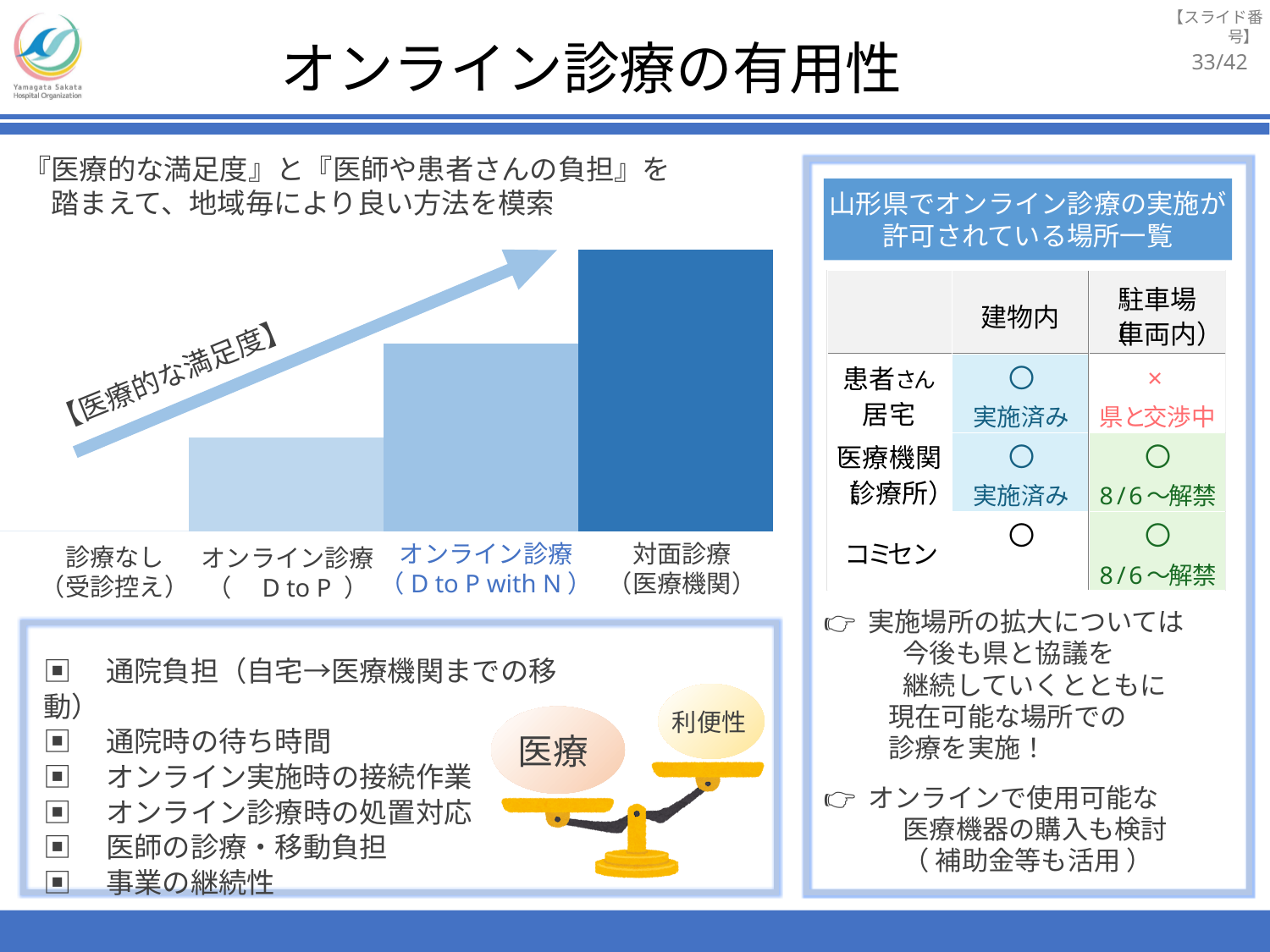
In the bar chart on the left, which category has the shortest bar? 診療なし（受診控え） What kind of chart is shown on the left side of the slide under the heading about 医療的な満足度? bar chart In the bar chart on the left, which bar is taller: オンライン診療（D to P）or オンライン診療（D to P with N）? オンライン診療（D to P with N） In the bar chart on the left, do the bars rise or fall from left to right? rise In the bar chart on the left, which bar is taller: オンライン診療（D to P with N）or 対面診療（医療機関）? 対面診療（医療機関） In the bar chart on the left, which bar is taller: 診療なし（受診控え）or 対面診療（医療機関）? 対面診療（医療機関） In the bar chart on the left, which category label is written in blue text? オンライン診療（D to P with N） What label is written along the arrow above the bars in the bar chart on the left? 【医療的な満足度】 In the bar chart on the left, which category has the tallest bar? 対面診療（医療機関） How many categories (bars) does the bar chart on the left of the slide have? 4